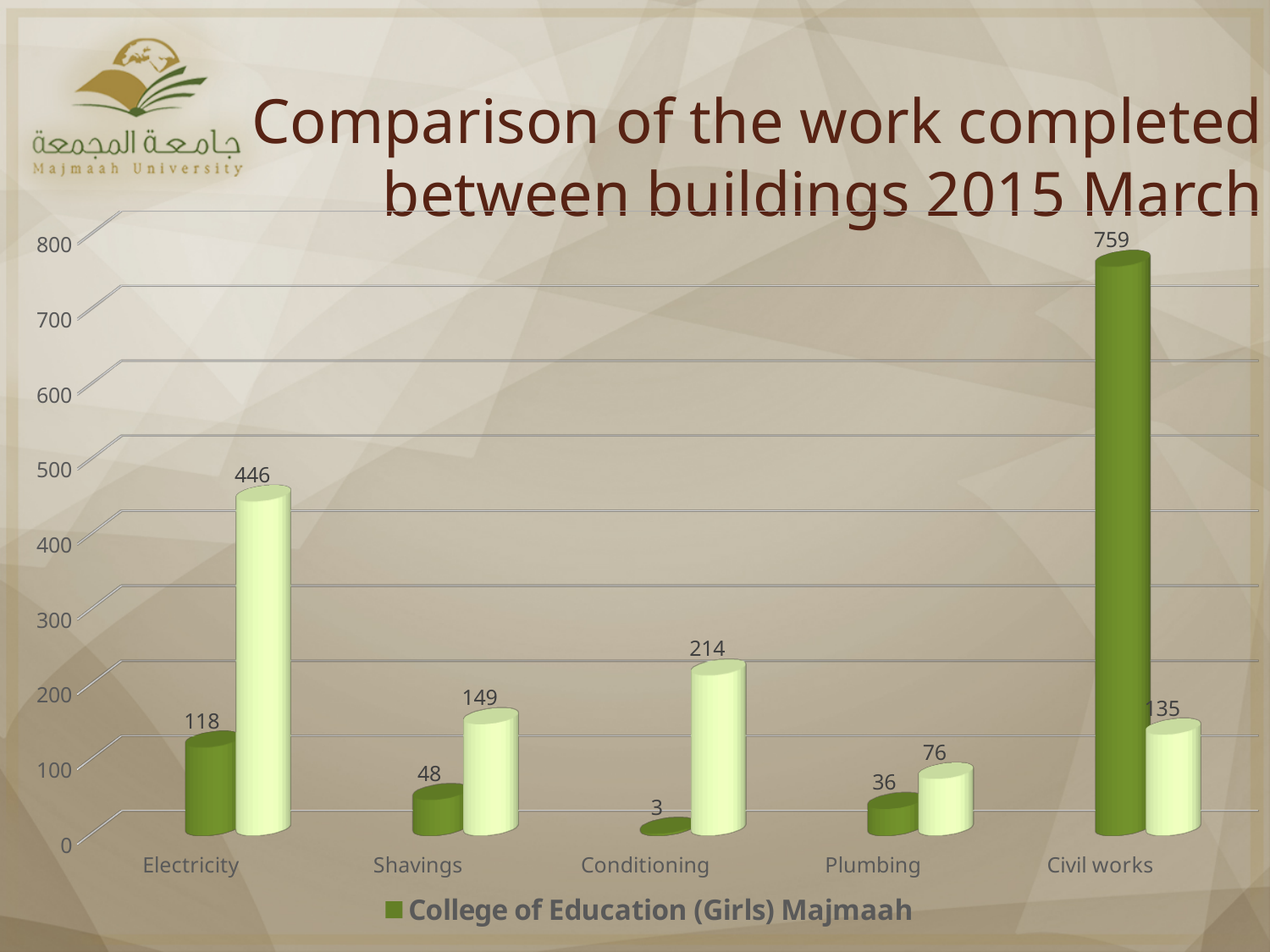
Which category has the highest value in the College of Education (Girls) Majmaah series? Civil works What is the title of the chart? Comparison of the work completed between buildings 2015 March What is the value for Plumbing in the College of Education (Girls) Majmaah series? 36 What is the value for Electricity in the College of Education (Girls) Majmaah series? 118 What is the difference between the Civil works and Electricity values in the College of Education (Girls) Majmaah series? 641 Which category has the lowest value in the College of Education (Girls) Majmaah series? Conditioning What kind of chart is shown on the slide? Bar chart Is the Civil works value for College of Education (Girls) Majmaah greater or less than 700? greater What is the value for Civil works in the College of Education (Girls) Majmaah series? 759 How many series does the legend list? 1 How many categories are shown on the x axis? 5 In the College of Education (Girls) Majmaah series, which is larger: Shavings or Plumbing? Shavings